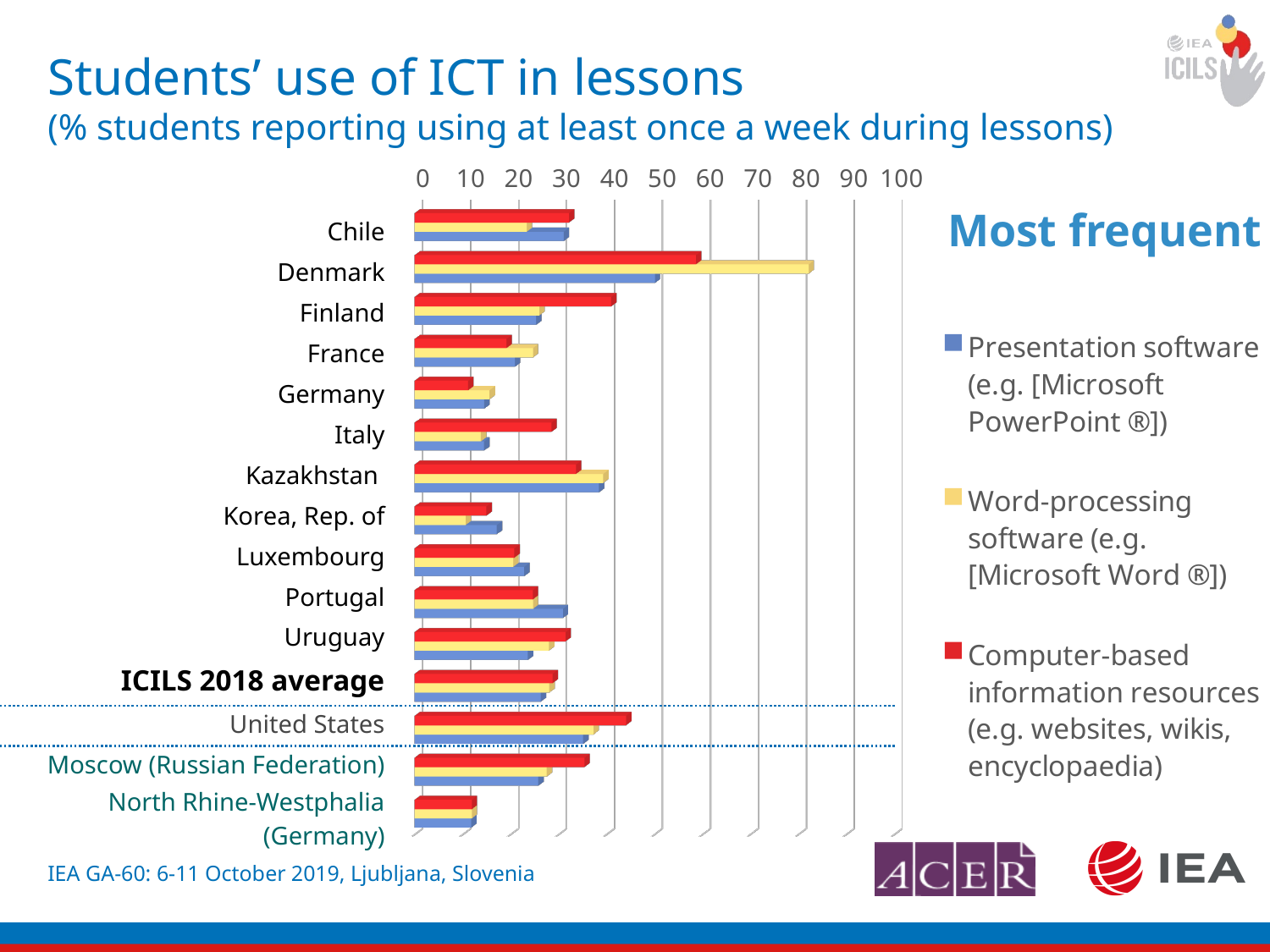
Which country has the larger value for computer-based information resources: Kazakhstan or Korea, Rep. of? Kazakhstan How many series does the legend list? 3 Which is larger for Denmark: the value for word-processing software or the value for presentation software? word-processing software Which colour represents computer-based information resources in the chart? red Which country has the highest value for word-processing software? Denmark What is the title of the chart? Students' use of ICT in lessons Is the value for computer-based information resources in Germany greater or less than 20? less Is the value for presentation software in Italy greater or less than 20? less What kind of chart is shown on the slide? bar chart How many countries or education systems (including the ICILS 2018 average) are plotted on the chart? 15 Is the value for computer-based information resources in the United States greater or less than 40? greater